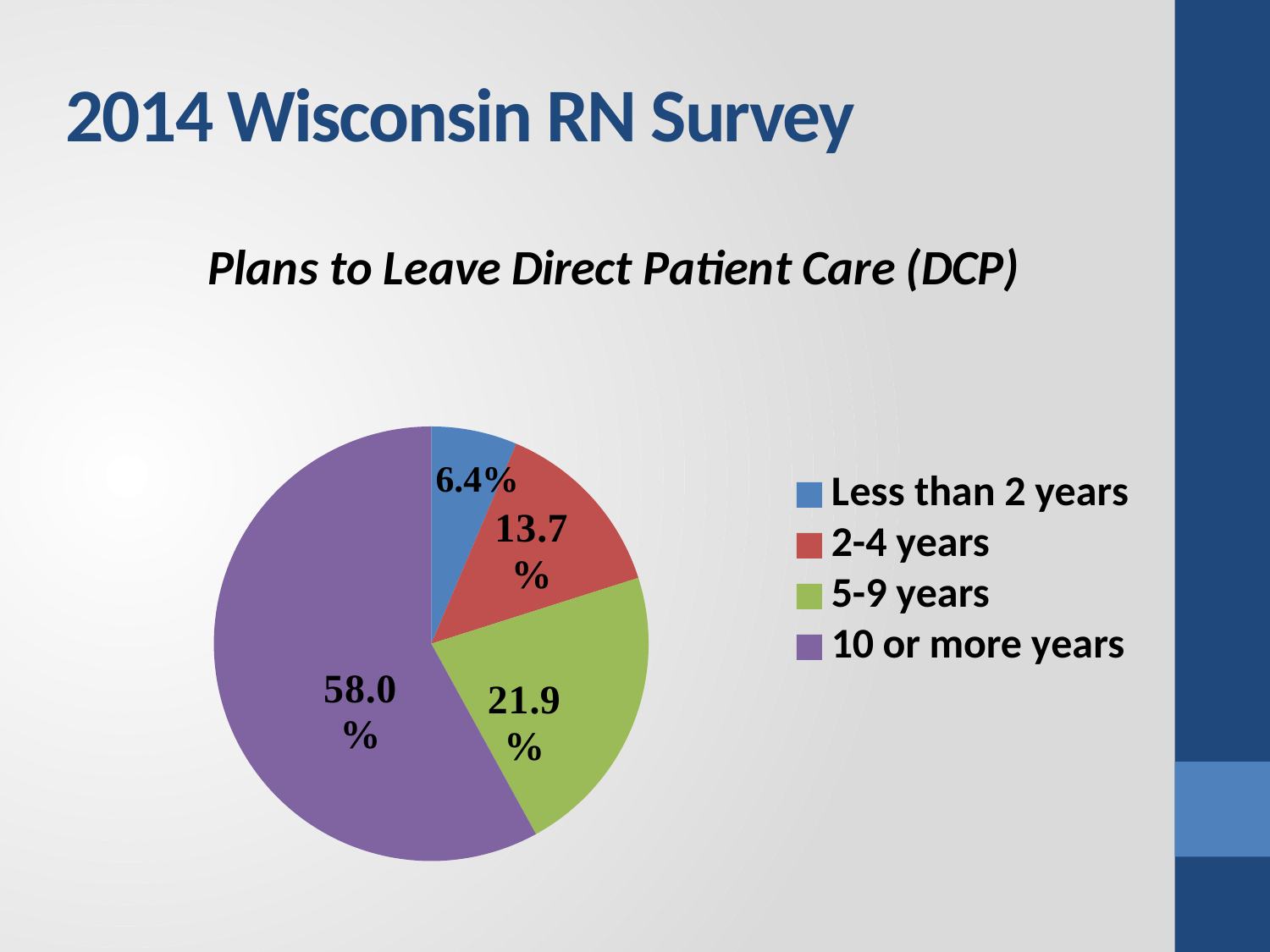
What colour is the 10 or more years slice? purple What percentage of respondents plan to leave direct patient care in less than 2 years? 6.4% What is the difference between the 10 or more years slice and the 5-9 years slice? 36.1% How many categories does the pie chart have? 4 What is the value for the 5-9 years slice? 21.9% What is the value for the 2-4 years slice? 13.7% Which is larger, the 2-4 years slice or the 5-9 years slice? 5-9 years What type of chart is shown on the slide? pie chart What is the title of the chart? Plans to Leave Direct Patient Care (DCP) Which category has the largest share of the pie? 10 or more years Which category has the smallest share of the pie? Less than 2 years What is the value for the 10 or more years slice? 58.0%